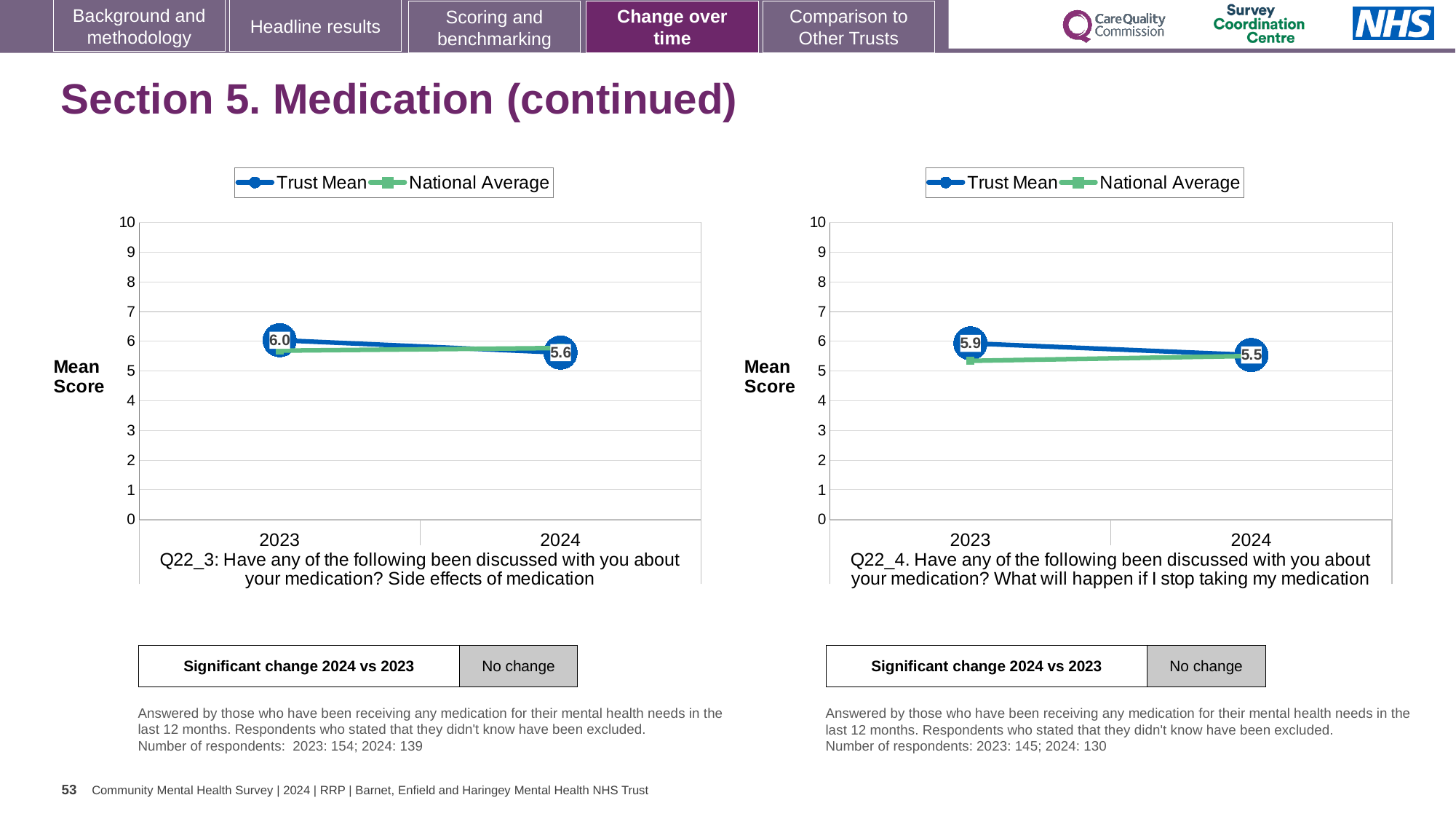
In the right chart (Q22_4: What will happen if I stop taking my medication), what is the Trust Mean for 2024? 5.5 What type of chart is used in the left chart (Q22_3)? line chart In the right chart (Q22_4), is the National Average for 2023 greater or less than 7? less In the left chart (Q22_3), does the Trust Mean rise or fall from 2023 to 2024? fall In the right chart (Q22_4), which year has the higher Trust Mean, 2023 or 2024? 2023 In the left chart (Q22_3: Side effects of medication), what is the Trust Mean for 2023? 6.0 In the right chart (Q22_4), what is the difference between the Trust Mean in 2023 and in 2024? 0.4 In the left chart (Q22_3: Side effects of medication), what is the Trust Mean for 2024? 5.6 In the right chart (Q22_4: What will happen if I stop taking my medication), what is the Trust Mean for 2023? 5.9 How many series does the legend of the right chart (Q22_4) list? 2 In the left chart (Q22_3), by how much did the Trust Mean change from 2023 to 2024? 0.4 How many years are shown on the x axis of the left chart (Q22_3)? 2